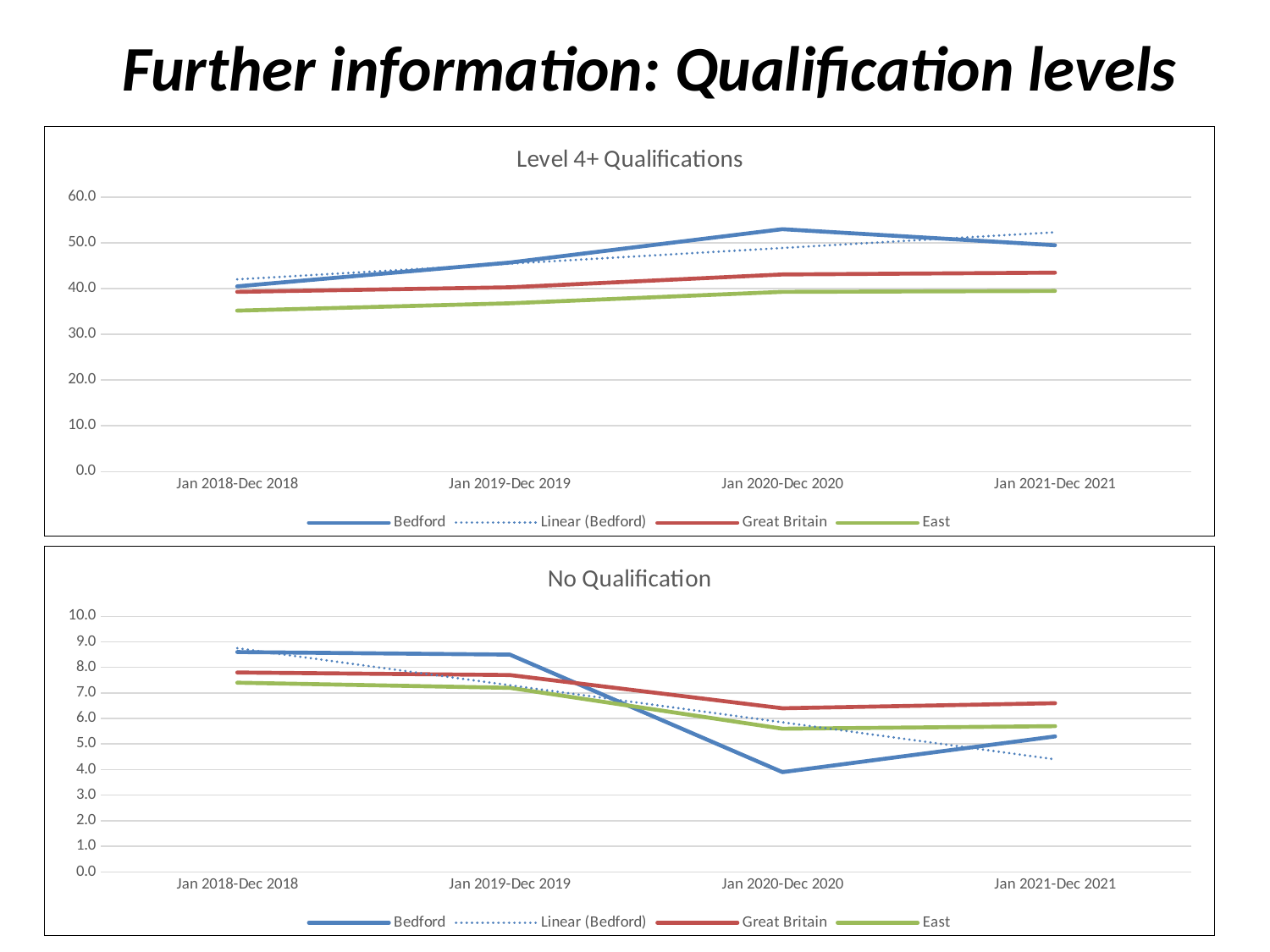
In the 'No Qualification' chart, is the Bedford value for Jan 2020-Dec 2020 greater or less than 5.0? less How many time periods are shown on the x axis of the 'Level 4+ Qualifications' chart? 4 In the 'No Qualification' chart, is the Great Britain value for Jan 2018-Dec 2018 greater or less than 7.0? greater In the 'Level 4+ Qualifications' chart, is the East value for Jan 2018-Dec 2018 greater or less than 40.0? less What kind of chart is the 'Level 4+ Qualifications' chart? line chart In the 'Level 4+ Qualifications' chart, does the East line rise or fall from Jan 2018-Dec 2018 to Jan 2021-Dec 2021? rise What is the title of the lower chart on the slide? No Qualification In the 'No Qualification' chart, for Jan 2020-Dec 2020, which is larger: Great Britain or Bedford? Great Britain In the 'Level 4+ Qualifications' chart, in which period is the Bedford value highest? Jan 2020-Dec 2020 How many entries does the legend of the 'No Qualification' chart list? 4 In the 'No Qualification' chart, in which period is the Bedford value lowest? Jan 2020-Dec 2020